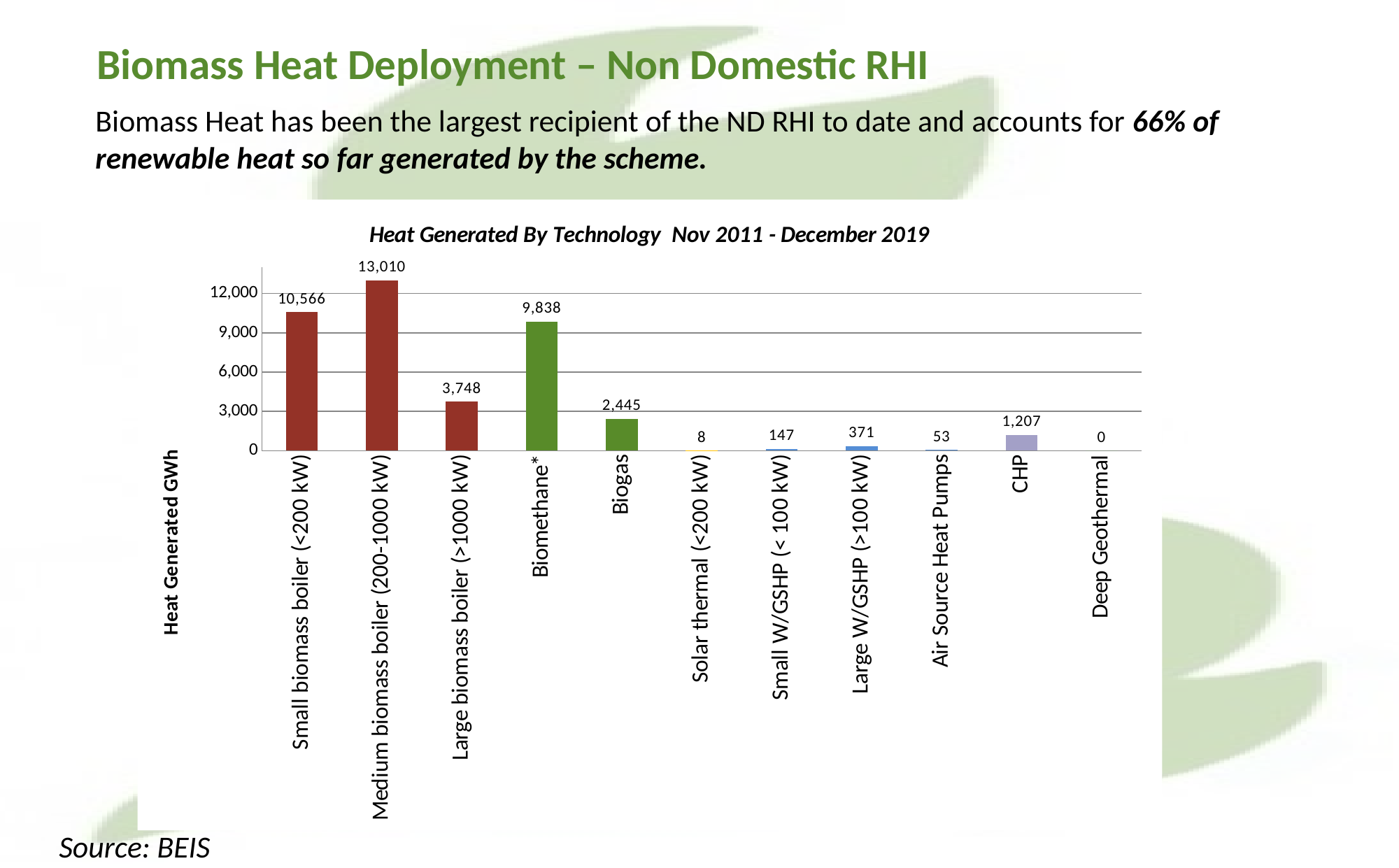
What is the heat generated by CHP? 1,207 Is the value for Biomethane* greater or less than 9,000? greater What is the difference in heat generated between Medium biomass boiler (200-1000 kW) and Small biomass boiler (<200 kW)? 2,444 What is the heat generated by Medium biomass boiler (200-1000 kW)? 13,010 What is the heat generated by Air Source Heat Pumps? 53 What is the heat generated by Biomethane*? 9,838 What is the title of the chart? Heat Generated By Technology Nov 2011 - December 2019 Which technology has the highest heat generated? Medium biomass boiler (200-1000 kW) Which technology has the lowest heat generated? Deep Geothermal What kind of chart is shown on the slide? Bar chart Which has a higher heat generated value, Large biomass boiler (>1000 kW) or Biogas? Large biomass boiler (>1000 kW) How many technology categories are shown on the chart? 11